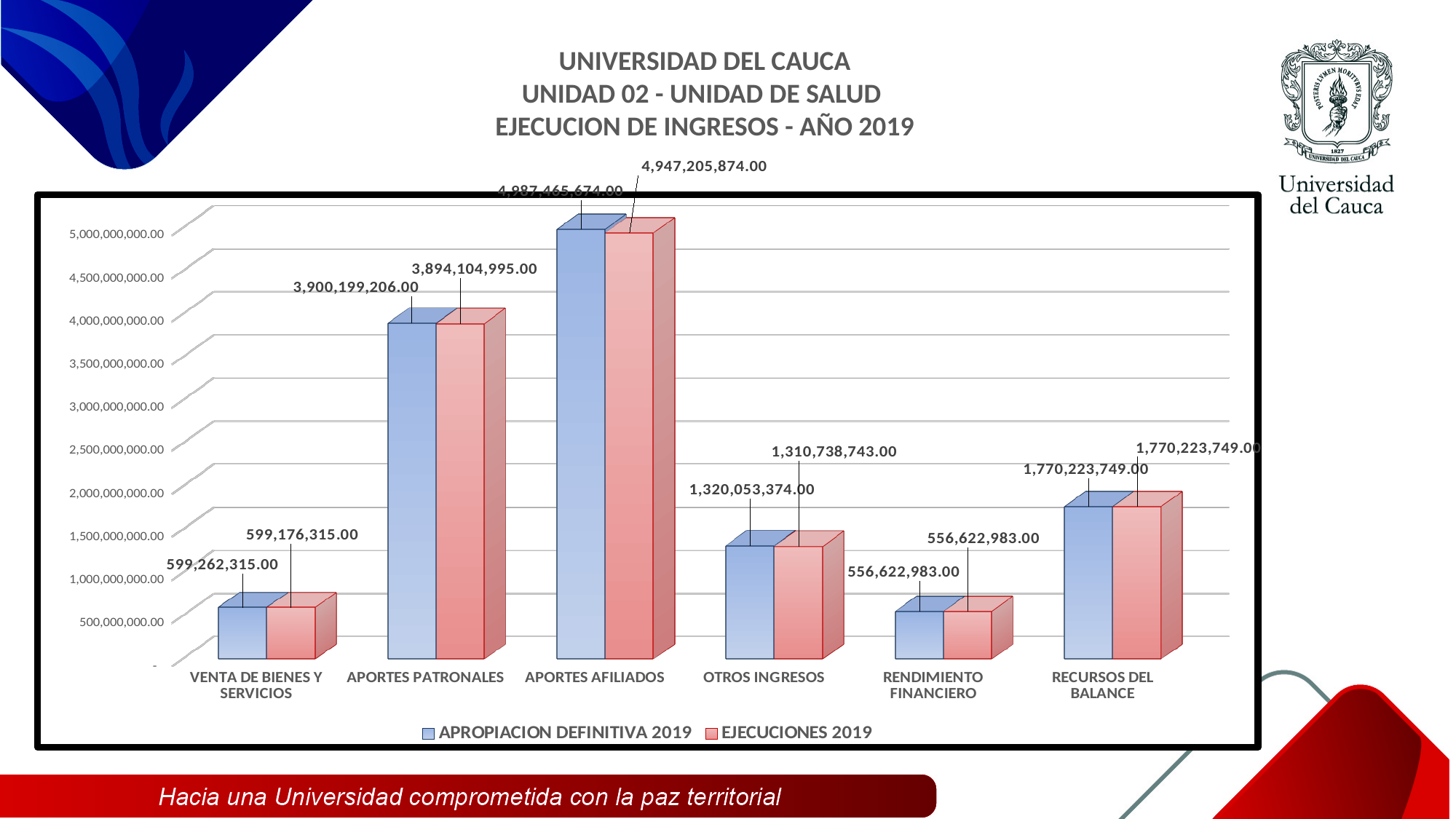
Which is larger: the EJECUCIONES 2019 value for RECURSOS DEL BALANCE or for OTROS INGRESOS? RECURSOS DEL BALANCE What is the APROPIACION DEFINITIVA 2019 value for APORTES PATRONALES? 3,900,199,206.00 What kind of chart is shown on the slide? Bar chart Which category has the lowest APROPIACION DEFINITIVA 2019 value? RENDIMIENTO FINANCIERO What is the EJECUCIONES 2019 value for APORTES AFILIADOS? 4,947,205,874.00 Which category has the highest EJECUCIONES 2019 value? APORTES AFILIADOS How many series does the legend list? 2 What is the APROPIACION DEFINITIVA 2019 value for RECURSOS DEL BALANCE? 1,770,223,749.00 What is the difference between the APROPIACION DEFINITIVA 2019 and EJECUCIONES 2019 values for VENTA DE BIENES Y SERVICIOS? 86,000.00 What is the EJECUCIONES 2019 value for OTROS INGRESOS? 1,310,738,743.00 How many categories are shown on the x axis? 6 What is the difference between the APROPIACION DEFINITIVA 2019 and EJECUCIONES 2019 values for OTROS INGRESOS? 9,314,631.00